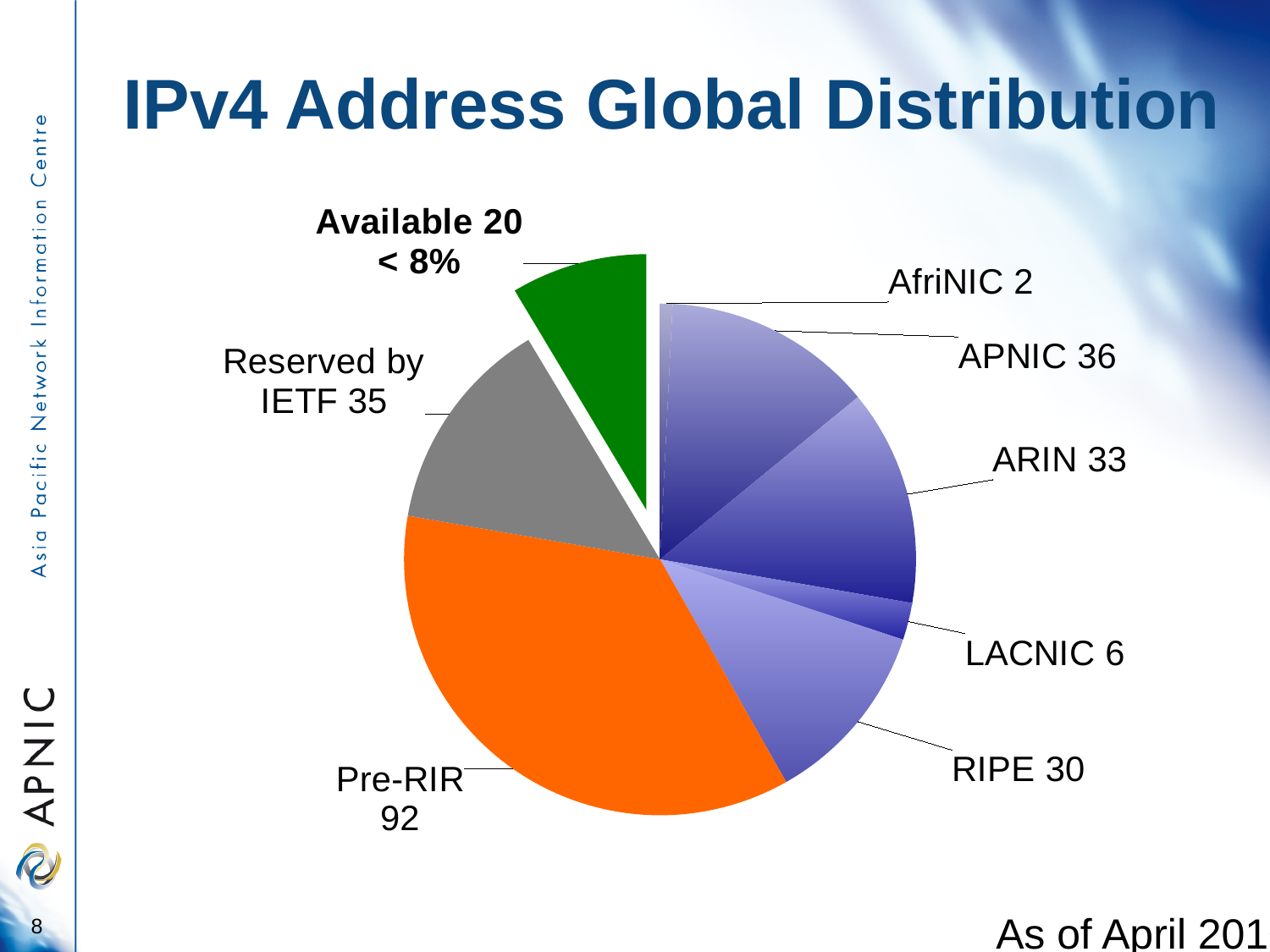
What type of chart is shown on the slide? pie chart Which category has the smallest slice in the pie chart? AfriNIC What is the difference between the values for APNIC and ARIN? 3 What is the value for Pre-RIR in the pie chart? 92 What is the value for Reserved by IETF in the pie chart? 35 How many slices does the pie chart have? 8 What is the value for APNIC in the pie chart? 36 What is the value for LACNIC in the pie chart? 6 Which category has the largest slice in the pie chart? Pre-RIR What share of the pie is shown for the Available slice? < 8% Which is larger, the value for ARIN or the value for RIPE? ARIN What is the difference between the values for Pre-RIR and RIPE? 62